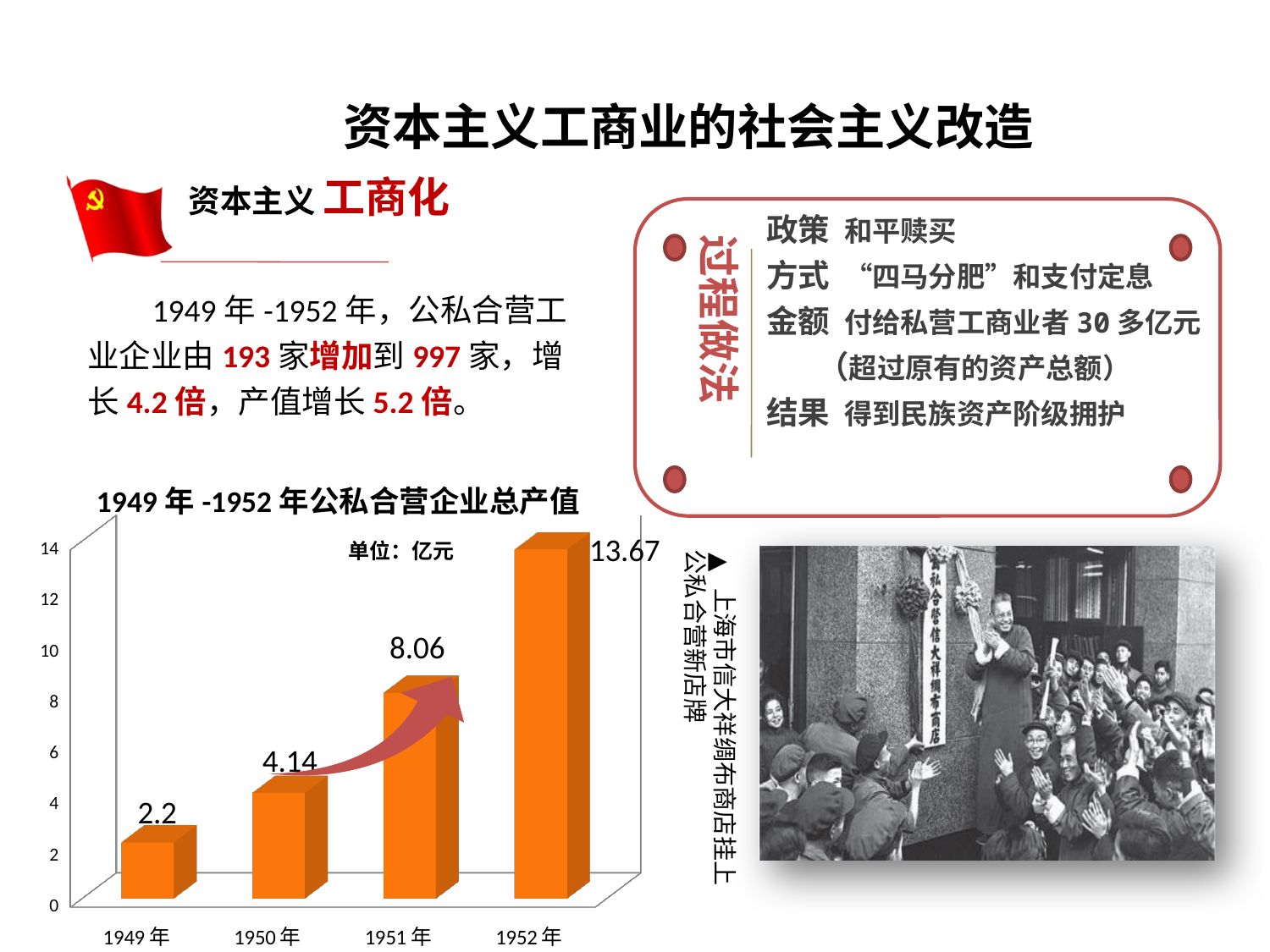
What is the difference between the values for 1951年 and 1950年? 3.92 What kind of chart is shown on the slide? bar chart What is the value for 1951年 in the chart? 8.06 What is the value for 1950年 in the chart? 4.14 Do the values rise or fall from 1949年 to 1952年? rise How many years are shown on the x axis of the chart? 4 Which is larger, the value for 1951年 or the value for 1950年? 1951年 What is the difference between the values for 1952年 and 1949年? 11.47 What is the value for 1949年 in the chart? 2.2 Which year has the highest value in the chart? 1952年 Which year has the lowest value in the chart? 1949年 What is the value for 1952年 in the chart? 13.67